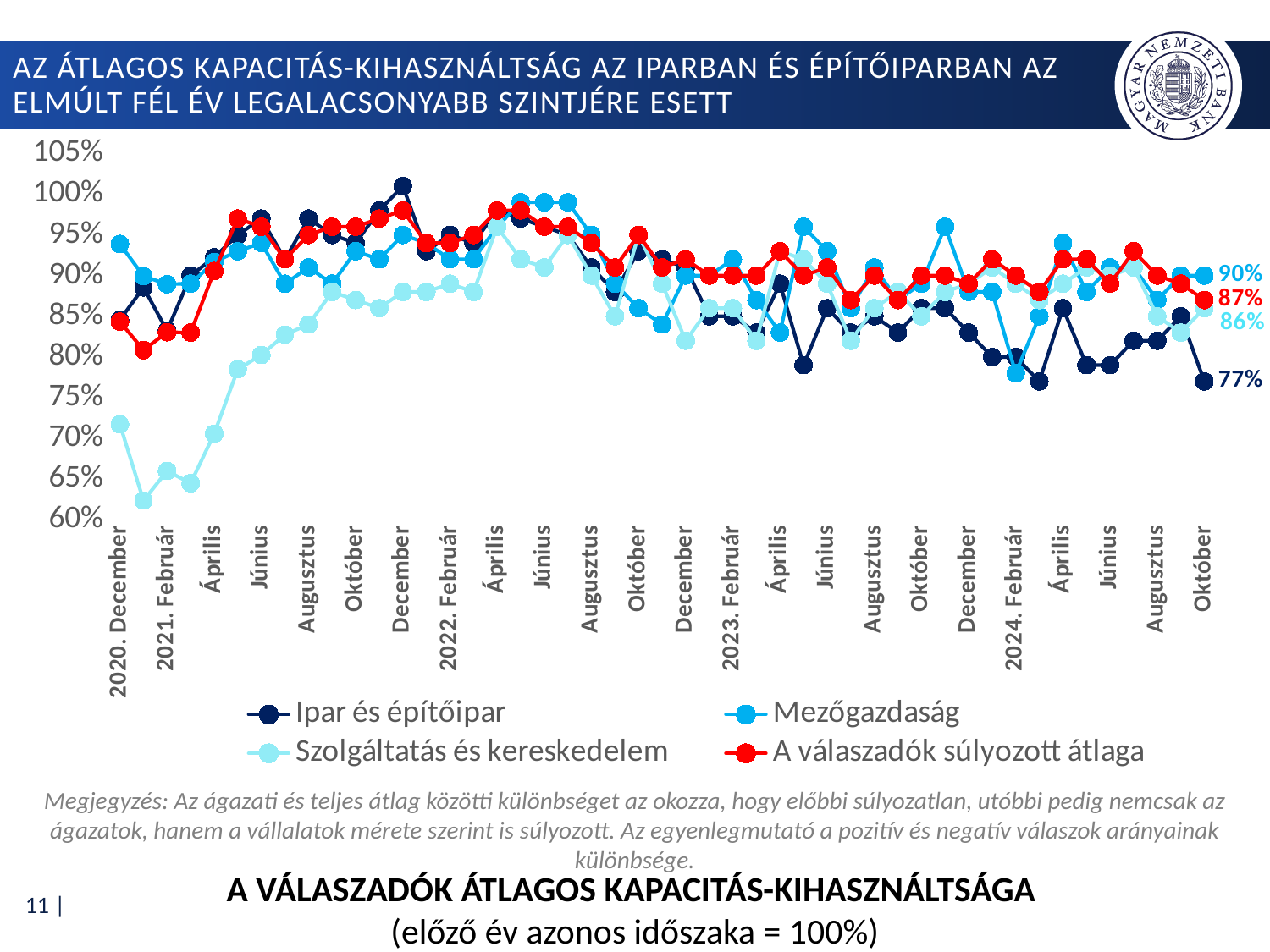
Does the Szolgáltatás és kereskedelem series rise or fall between 2020 December and 2022 Április? Rise What is the value for Ipar és építőipar at the last point (2024 Október)? 77% How many series does the legend list? 4 What is the difference between the Mezőgazdaság and Ipar és építőipar values at the last point (2024 Október)? 13 percentage points Is the value for Ipar és építőipar in 2021 December greater or less than 95%? greater What is the value for Szolgáltatás és kereskedelem at the last point (2024 Október)? 86% What kind of chart is shown on the slide? Line chart Which series has the highest value at the last point (2024 Október)? Mezőgazdaság What is the value for A válaszadók súlyozott átlaga at the last point (2024 Október)? 87% Is the value for Szolgáltatás és kereskedelem in 2020 December greater or less than 75%? less Which series has the lowest value at the last point (2024 Október)? Ipar és építőipar What is the value for Mezőgazdaság at the last point (2024 Október)? 90%